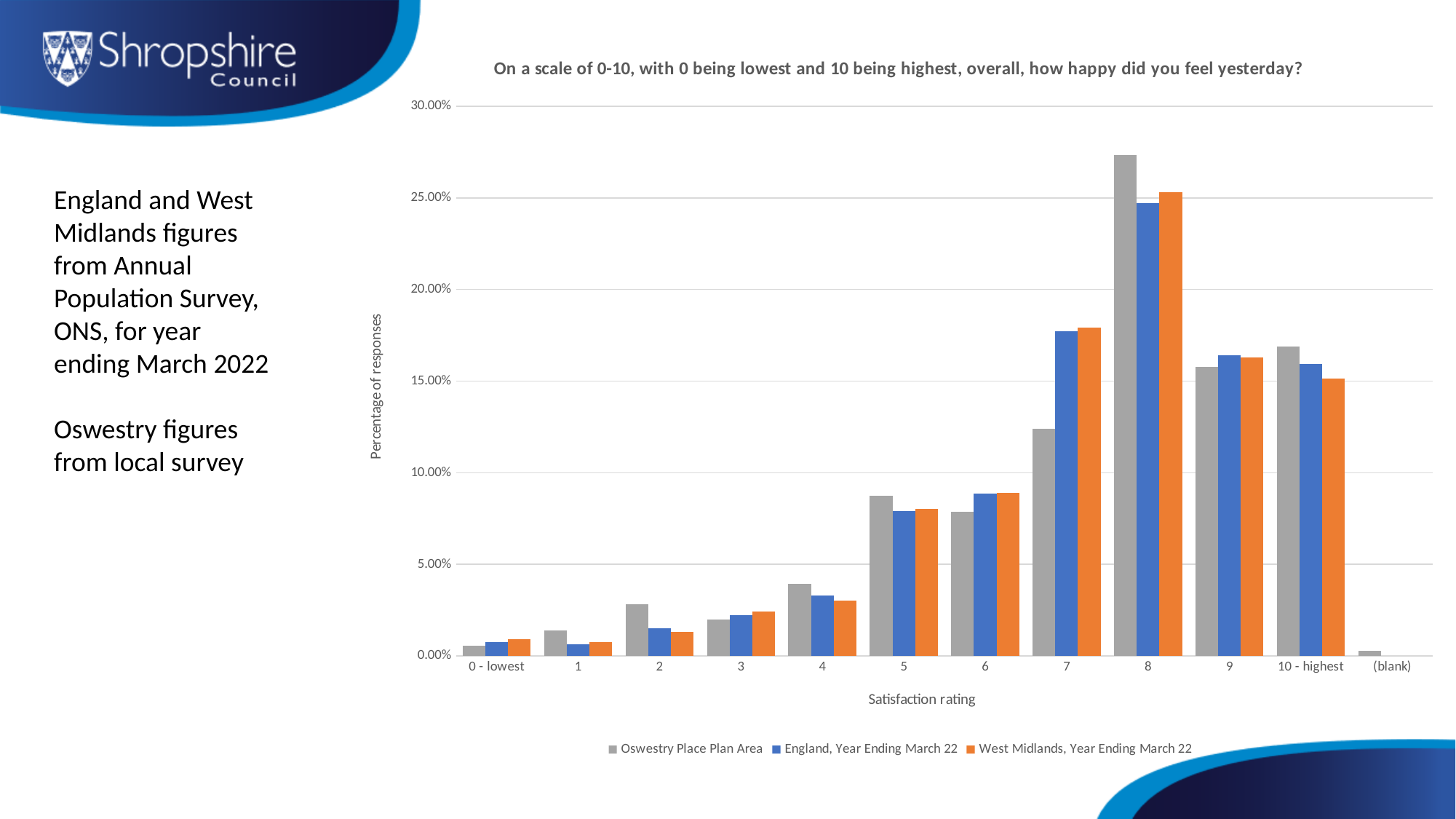
Which category has the lowest value for Oswestry Place Plan Area? (blank) Which satisfaction rating has the highest value for Oswestry Place Plan Area? 8 What is the label of the y axis? Percentage of responses Is the Oswestry Place Plan Area value for rating 4 greater or less than 5.00%? less Which satisfaction rating has the highest value for England, Year Ending March 22? 8 Is the Oswestry Place Plan Area value for rating 8 greater or less than 25.00%? greater Is the England, Year Ending March 22 value for rating 7 greater or less than 15.00%? greater What kind of chart is shown on the slide? bar chart How many satisfaction rating categories are shown on the x axis? 12 At rating 7, which is larger: the Oswestry Place Plan Area value or the England, Year Ending March 22 value? England, Year Ending March 22 How many series does the legend list? 3 At rating 10 - highest, which is larger: the Oswestry Place Plan Area value or the West Midlands, Year Ending March 22 value? Oswestry Place Plan Area